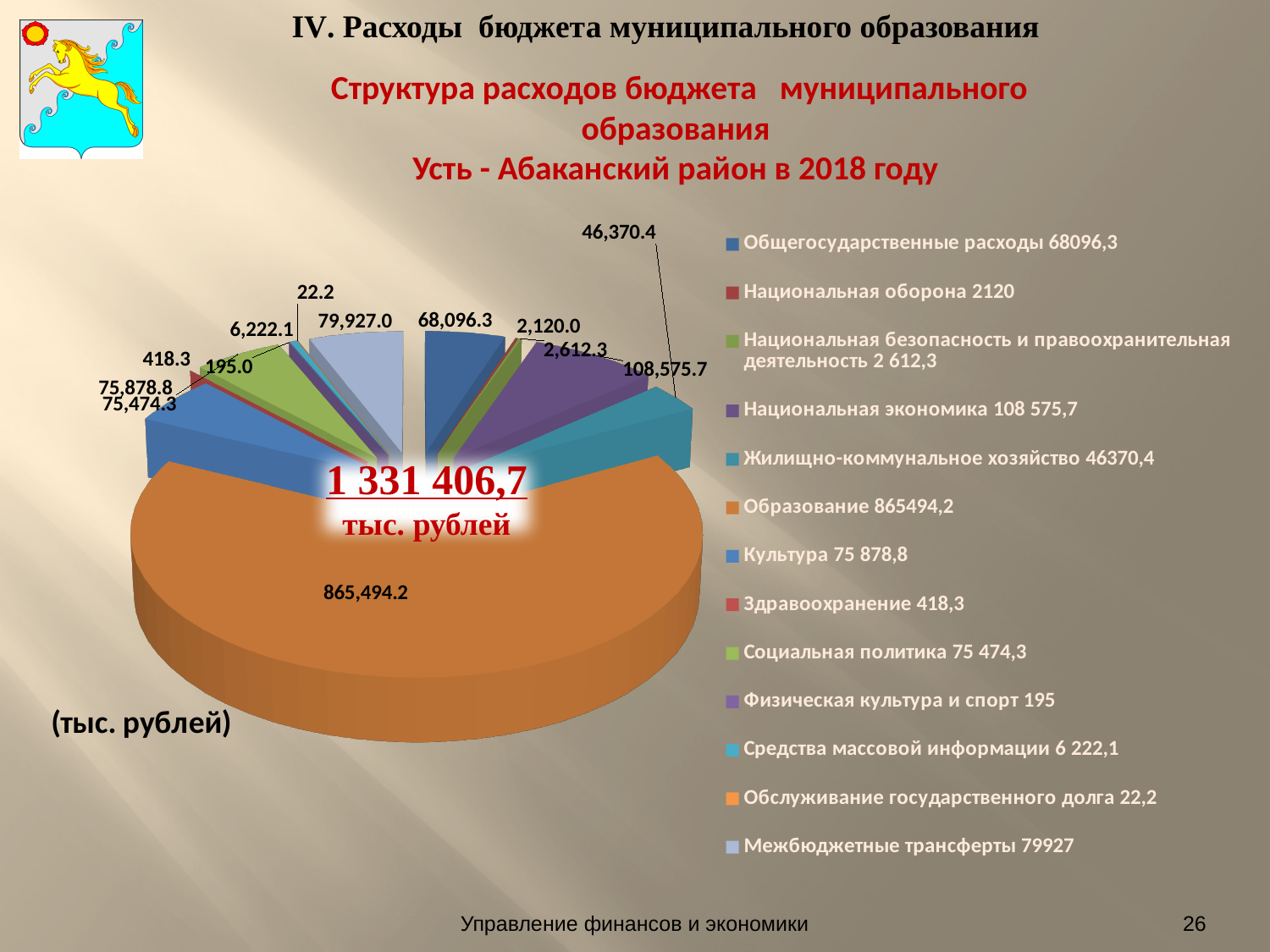
What is the value of the Здравоохранение slice? 418.3 What kind of chart is shown on the slide? pie chart Which is larger, Культура or Социальная политика? Культура What total is printed in the centre of the pie chart? 1 331 406,7 тыс. рублей Which category has the smallest value in the pie? Обслуживание государственного долга Which category has the largest slice of the pie? Образование What is the value of the Жилищно-коммунальное хозяйство slice? 46,370.4 How many categories does the pie chart have? 13 What is the difference between the Национальная экономика and Общегосударственные расходы values? 40,479.4 What is the value of the Национальная экономика slice? 108,575.7 In what units are the values of the chart given? тыс. рублей What is the value of the Межбюджетные трансферты slice? 79,927.0